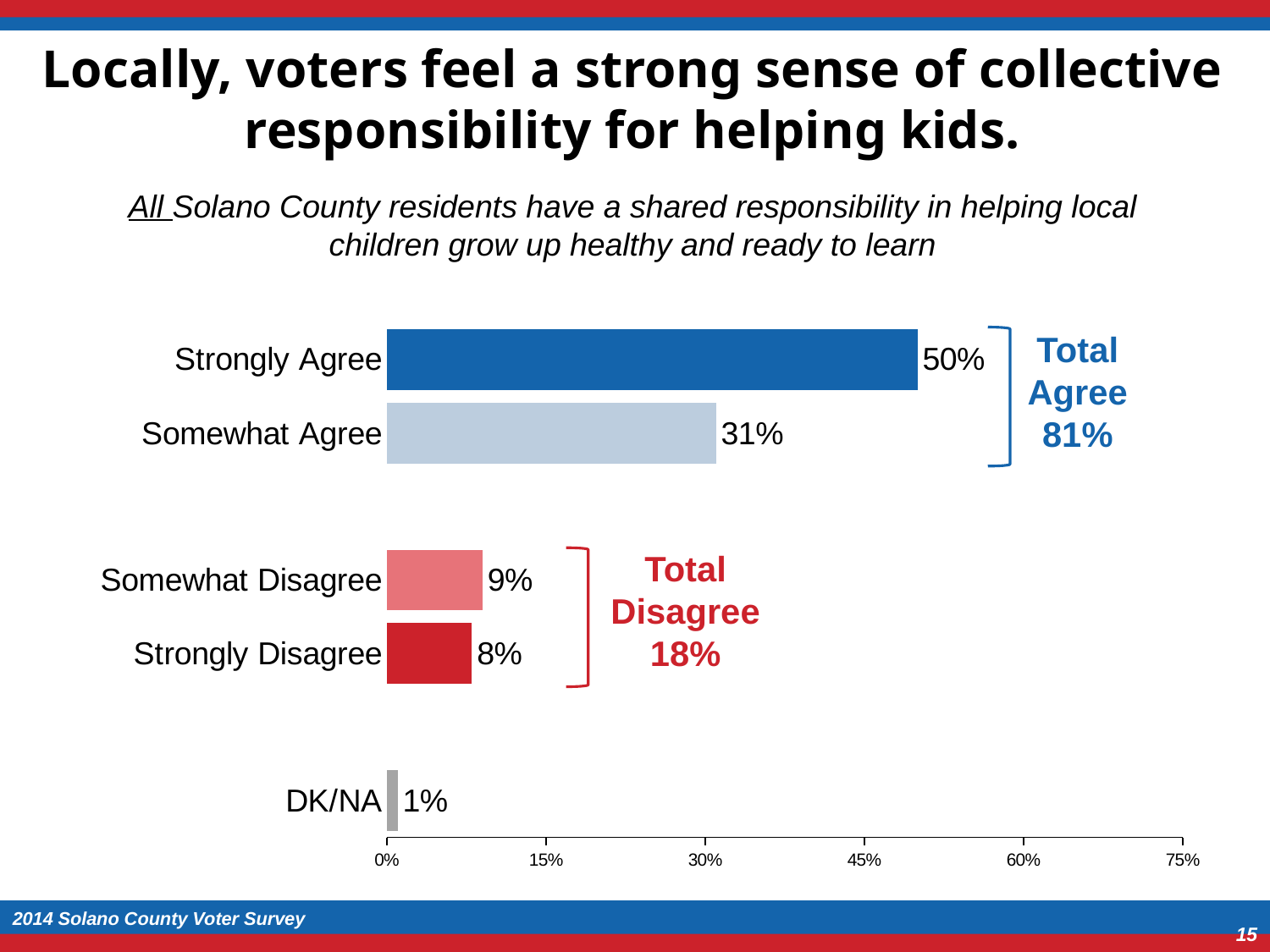
What percentage of respondents Somewhat Agree? 31% What percentage of respondents Strongly Agree? 50% What is the Total Agree percentage shown on the slide? 81% What kind of chart is shown on the slide? Bar chart Which response category has the highest percentage? Strongly Agree Which is larger, Somewhat Disagree or Strongly Disagree? Somewhat Disagree What percentage of respondents answered DK/NA? 1% What percentage of respondents Somewhat Disagree? 9% Which response category has the lowest percentage? DK/NA How many response categories are shown in the chart? 5 What is the difference between the Strongly Agree and Somewhat Agree percentages? 19% What percentage of respondents Strongly Disagree? 8%